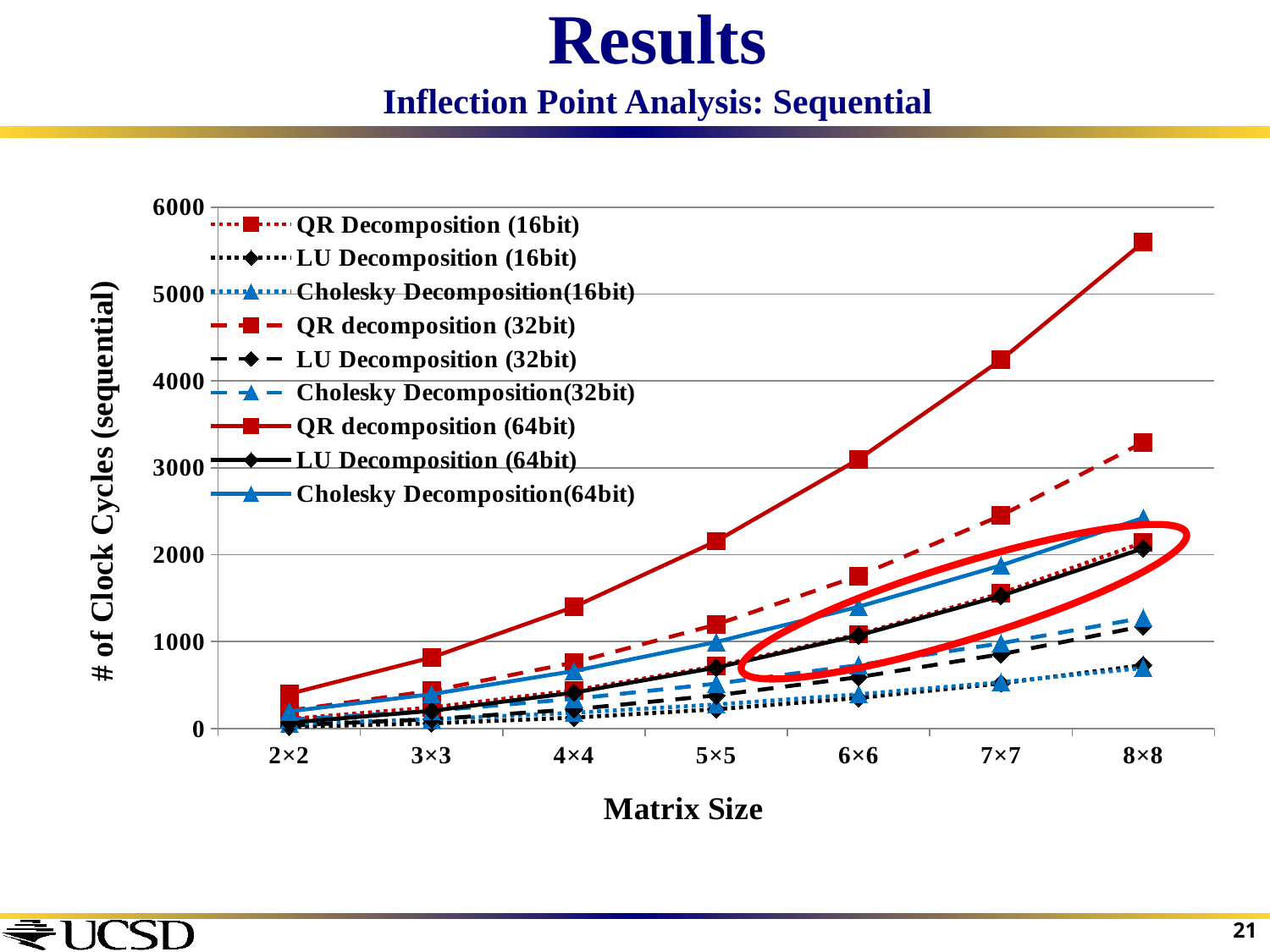
Is the value for LU Decomposition (16bit) at 8×8 greater or less than 1000? less How many series does the legend list? 9 Which series has the highest value at matrix size 8×8? QR decomposition (64bit) What kind of chart is shown on the slide? line chart What is the label of the y axis? # of Clock Cycles (sequential) Do the values for QR decomposition (64bit) rise or fall as matrix size increases from 2×2 to 8×8? rise Is the value for QR decomposition (64bit) at 5×5 greater or less than 1000? greater At matrix size 8×8, which is larger: QR decomposition (64bit) or QR decomposition (32bit)? QR decomposition (64bit) Is the value for QR decomposition (64bit) at 7×7 greater or less than 4000? greater How many matrix sizes are plotted along the x axis? 7